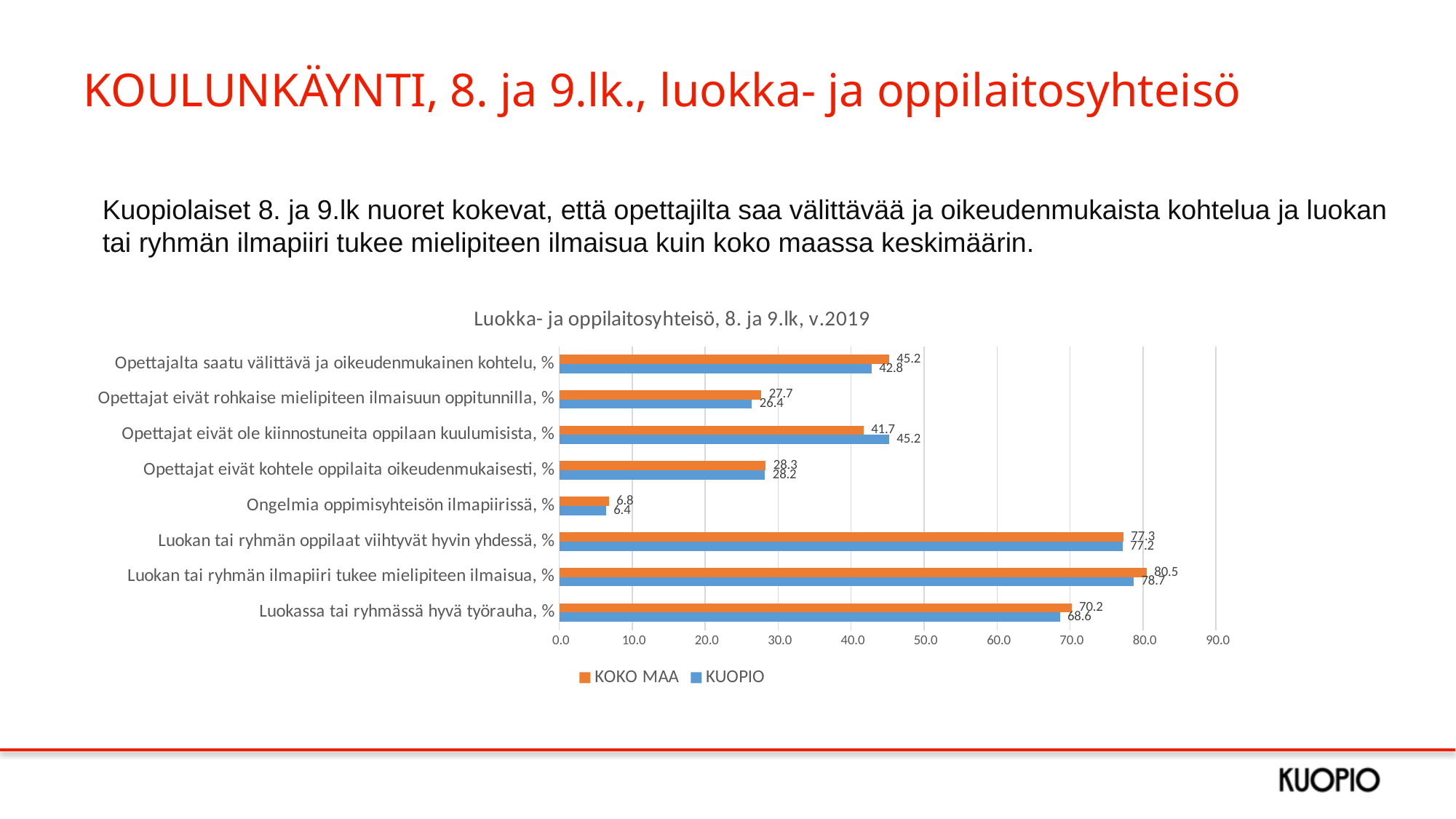
What is the KUOPIO value for "Opettajat eivät ole kiinnostuneita oppilaan kuulumisista, %"? 45.2 What type of chart is shown on the slide? Bar chart How many series does the legend list? 2 How many categories are shown in the chart? 8 What is the KUOPIO value for "Opettajalta saatu välittävä ja oikeudenmukainen kohtelu, %"? 42.8 What is the difference between the KUOPIO and KOKO MAA values for "Opettajat eivät ole kiinnostuneita oppilaan kuulumisista, %"? 3.5 Is the KUOPIO value for "Luokan tai ryhmän oppilaat viihtyvät hyvin yhdessä, %" greater or less than 70.0? greater What is the difference between the KOKO MAA and KUOPIO values for "Opettajalta saatu välittävä ja oikeudenmukainen kohtelu, %"? 2.4 For "Luokassa tai ryhmässä hyvä työrauha, %", which is larger, KOKO MAA or KUOPIO? KOKO MAA What is the KOKO MAA value for "Luokan tai ryhmän ilmapiiri tukee mielipiteen ilmaisua, %"? 80.5 Which category has the highest KUOPIO value? Luokan tai ryhmän ilmapiiri tukee mielipiteen ilmaisua, % Which category has the lowest KOKO MAA value? Ongelmia oppimisyhteisön ilmapiirissä, %